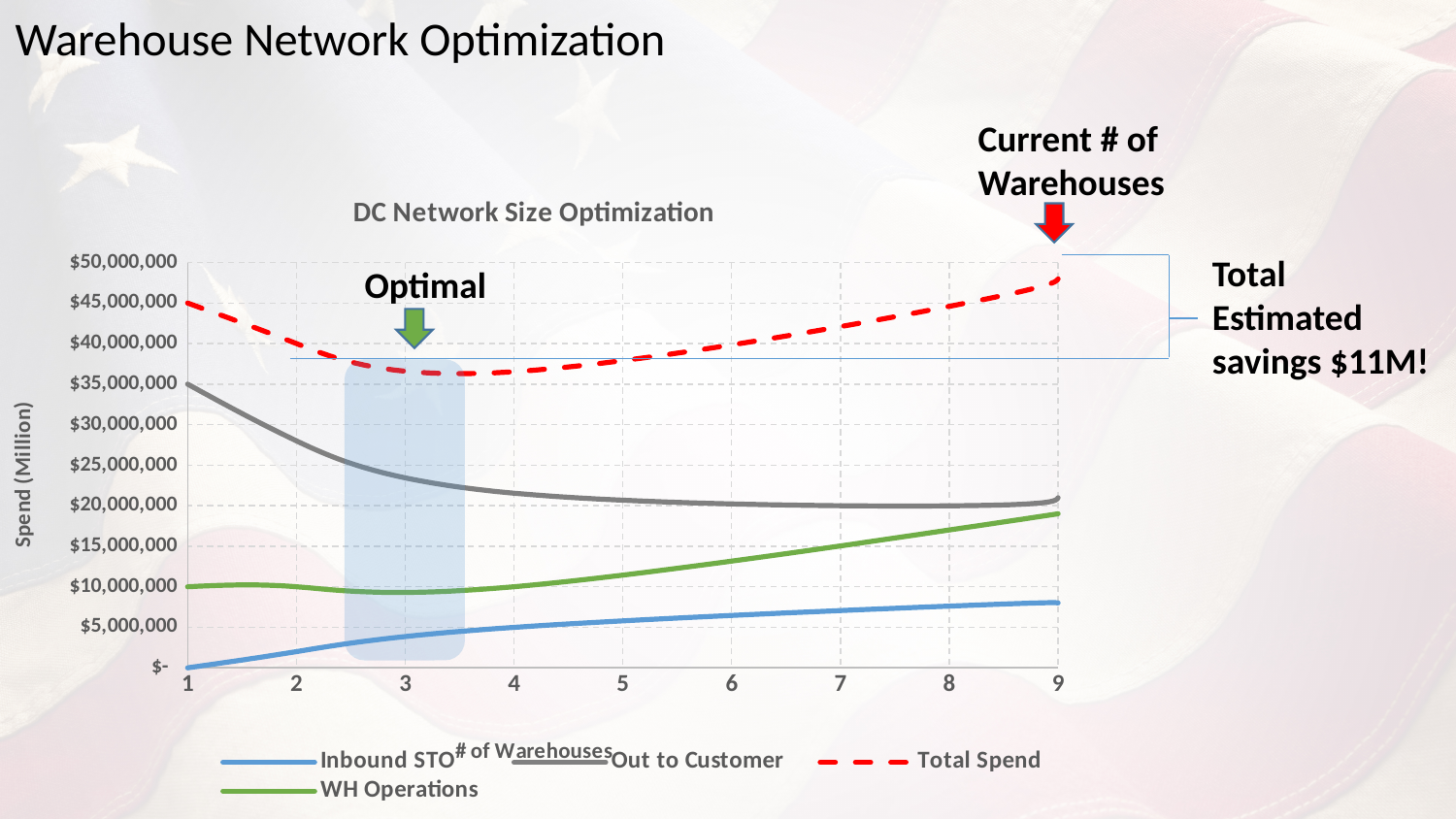
How many values of # of Warehouses are plotted along the x axis? 9 What is the title of the chart? DC Network Size Optimization How many series does the legend list? 4 Is the Inbound STO value at 9 warehouses greater or less than $10,000,000? less Is the Total Spend value at 9 warehouses greater or less than $45,000,000? greater Is the Total Spend value at 3 warehouses greater or less than $40,000,000? less At 1 warehouse, which is larger: Out to Customer or WH Operations? Out to Customer Does the Inbound STO series rise or fall as the number of warehouses increases from 1 to 9? rise Does the Out to Customer series rise or fall as the number of warehouses increases from 1 to 9? fall What kind of chart is shown on the slide? line chart